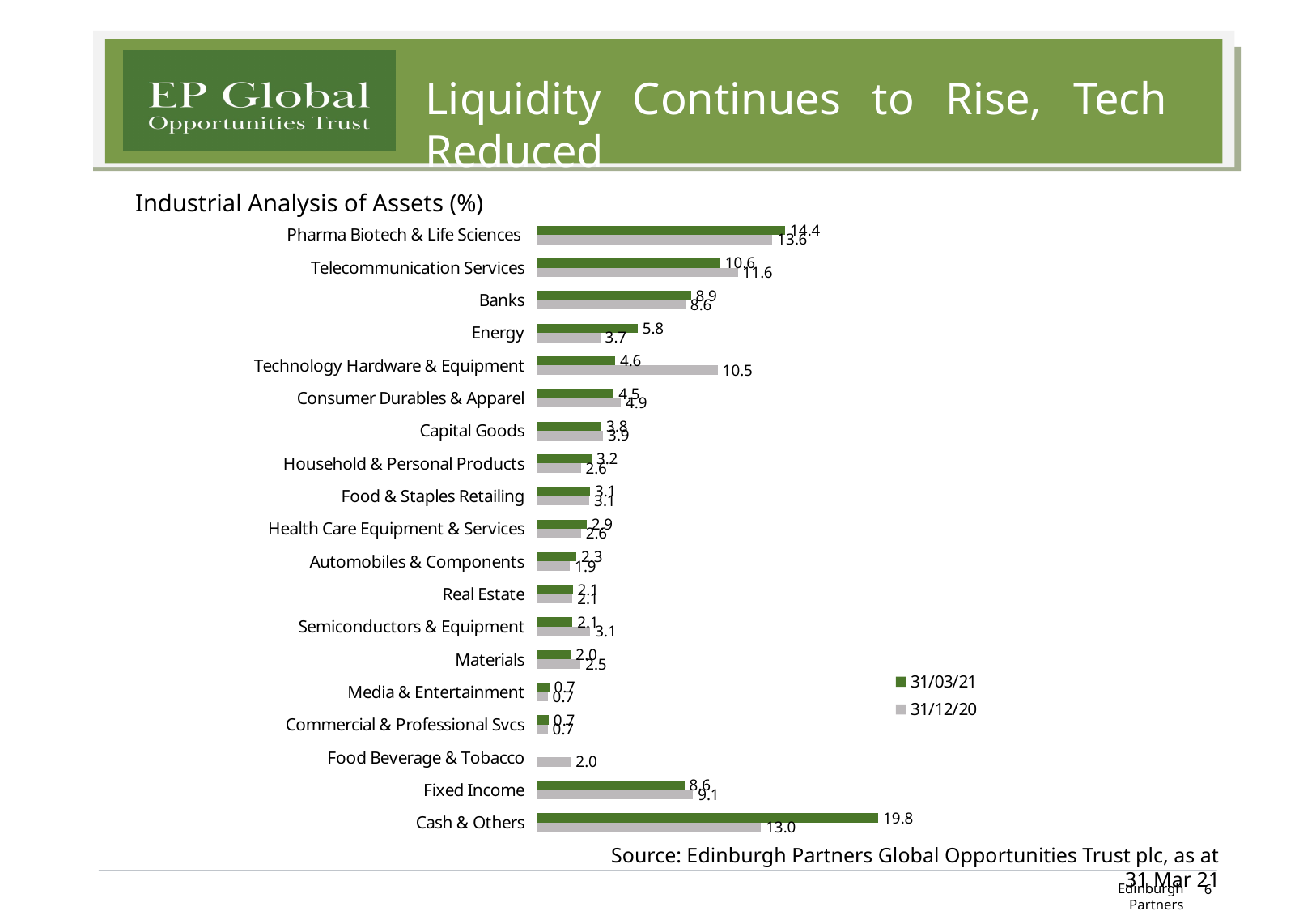
What is the value for Cash & Others in the 31/03/21 series? 19.8 What is the value for Food Beverage & Tobacco in the 31/12/20 series? 2.0 Which category has the highest value in the 31/03/21 series? Cash & Others How many categories are shown on the chart? 19 How many series does the legend list? 2 What is the value for Technology Hardware & Equipment in the 31/12/20 series? 10.5 What is the difference between the 31/03/21 and 31/12/20 values for Energy? 2.1 What is the value for Fixed Income in the 31/03/21 series? 8.6 What is the difference between the 31/03/21 and 31/12/20 values for Cash & Others? 6.8 Which category has the highest value in the 31/12/20 series? Pharma Biotech & Life Sciences What kind of chart is shown on the slide? Bar chart For Telecommunication Services, which is larger: the 31/03/21 value or the 31/12/20 value? 31/12/20